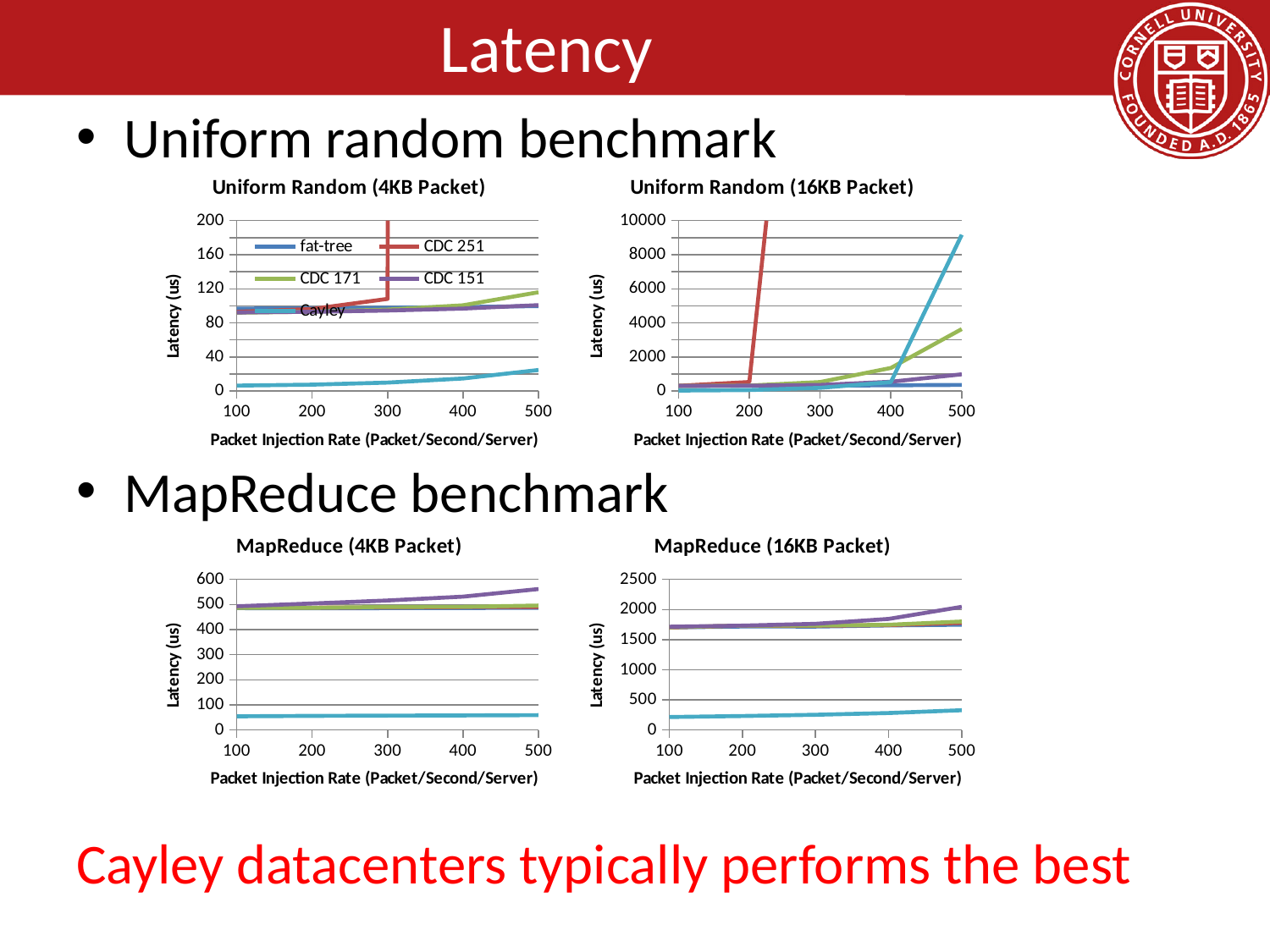
In the "Uniform Random (4KB Packet)" chart, how many tick values are shown on the x axis? 5 In the "MapReduce (4KB Packet)" chart, is the Cayley latency at an injection rate of 100 greater or less than 100? less In the "Uniform Random (4KB Packet)" chart, at an injection rate of 500, which is larger: the CDC 171 latency or the Cayley latency? CDC 171 In the "Uniform Random (16KB Packet)" chart, is the Cayley latency at an injection rate of 500 greater or less than 8000? greater In the "Uniform Random (4KB Packet)" chart, is the CDC 171 latency at an injection rate of 500 greater or less than 100? greater In the "Uniform Random (4KB Packet)" chart, how many series does the legend list? 5 What is the x-axis title of the "MapReduce (16KB Packet)" chart? Packet Injection Rate (Packet/Second/Server) What kind of chart is the "Uniform Random (4KB Packet)" chart? line chart